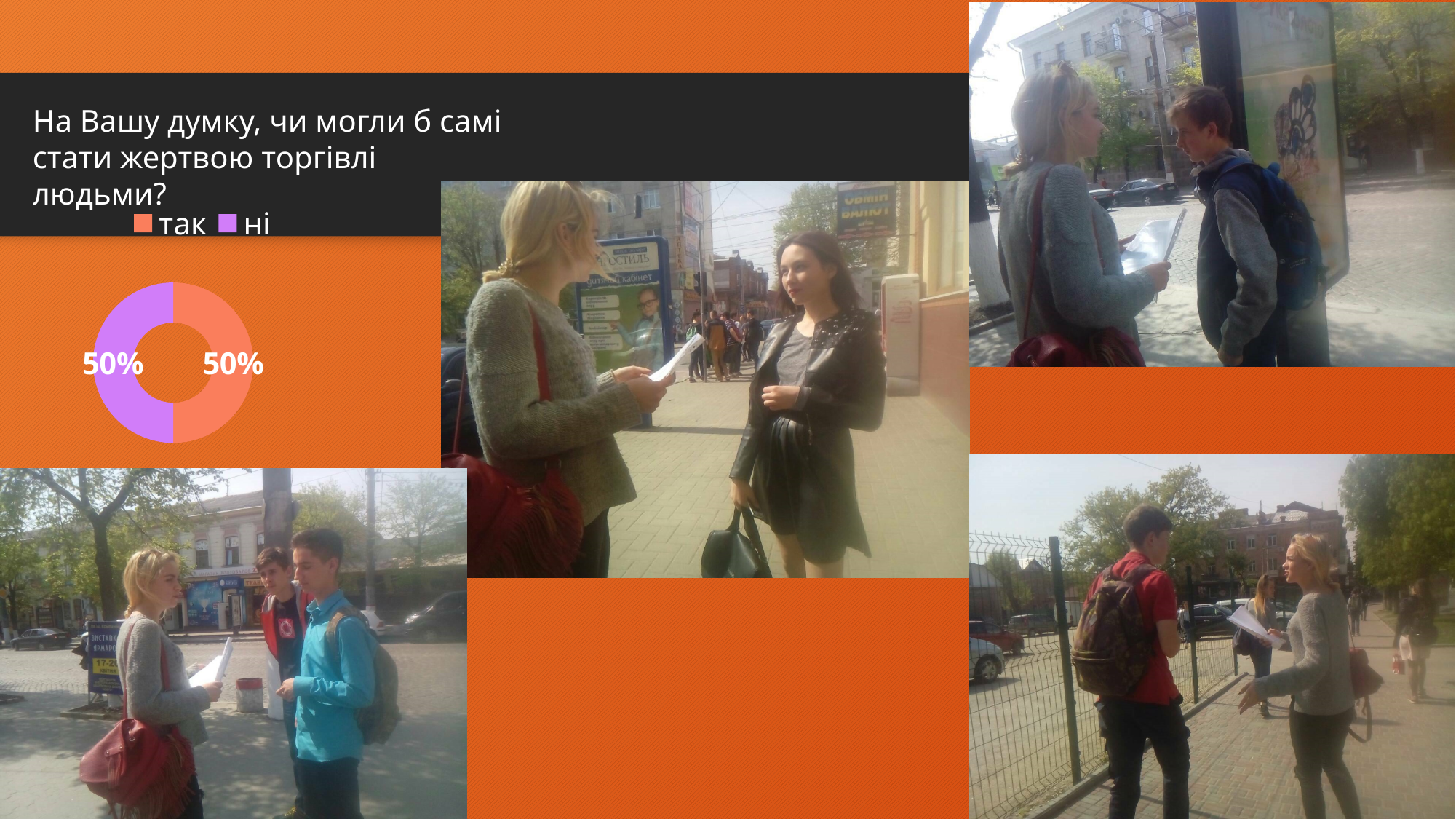
What is the title of the chart? На Вашу думку, чи могли б самі стати жертвою торгівлі людьми? What share of the chart does the "ні" slice take up? 50% How many slices does the chart have? 2 Which colour represents "ні" in the chart? purple How many entries does the chart legend list? 2 What kind of chart is shown on the slide? doughnut chart What percentage of respondents answered "так"? 50% What percentage of respondents answered "ні"? 50% What is the difference between the "так" and "ні" percentages? 0% What share of the chart does the "так" slice take up? 50%